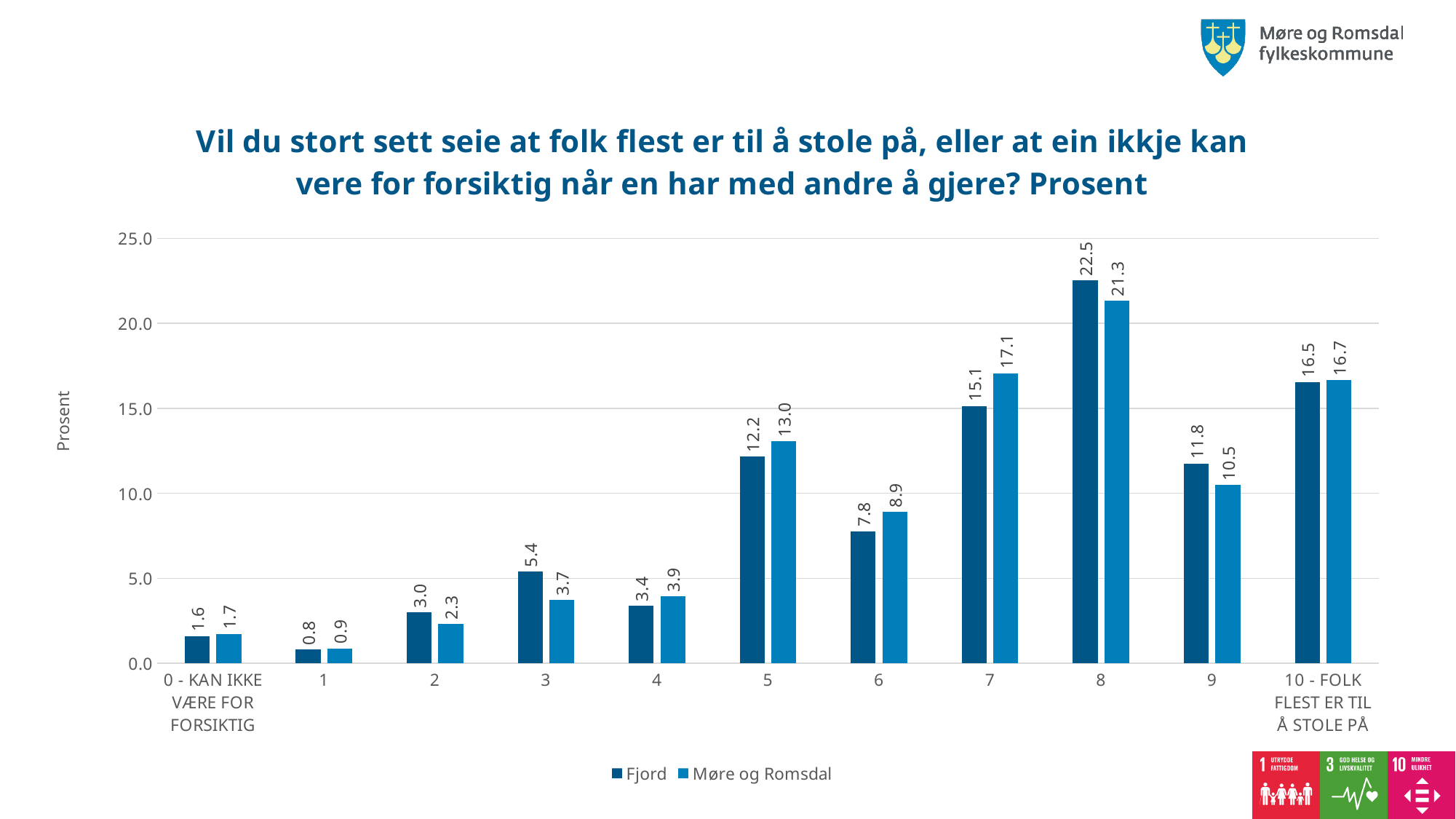
How many series does the legend list? 2 How many categories are shown on the x axis? 11 At category 7, which series has the larger value, Fjord or Møre og Romsdal? Møre og Romsdal What is the value for Møre og Romsdal at category 5? 13.0 What kind of chart is shown on the slide? bar chart What is the value for Fjord at category 3? 5.4 What is the label of the y axis? Prosent What is the difference between the Fjord and Møre og Romsdal values at category 9? 1.3 What is the value for Fjord at category 8? 22.5 Is the value for Fjord at category 6 greater or less than 10.0? less Which category has the lowest value for Fjord? 1 Which category has the highest value for Møre og Romsdal? 8